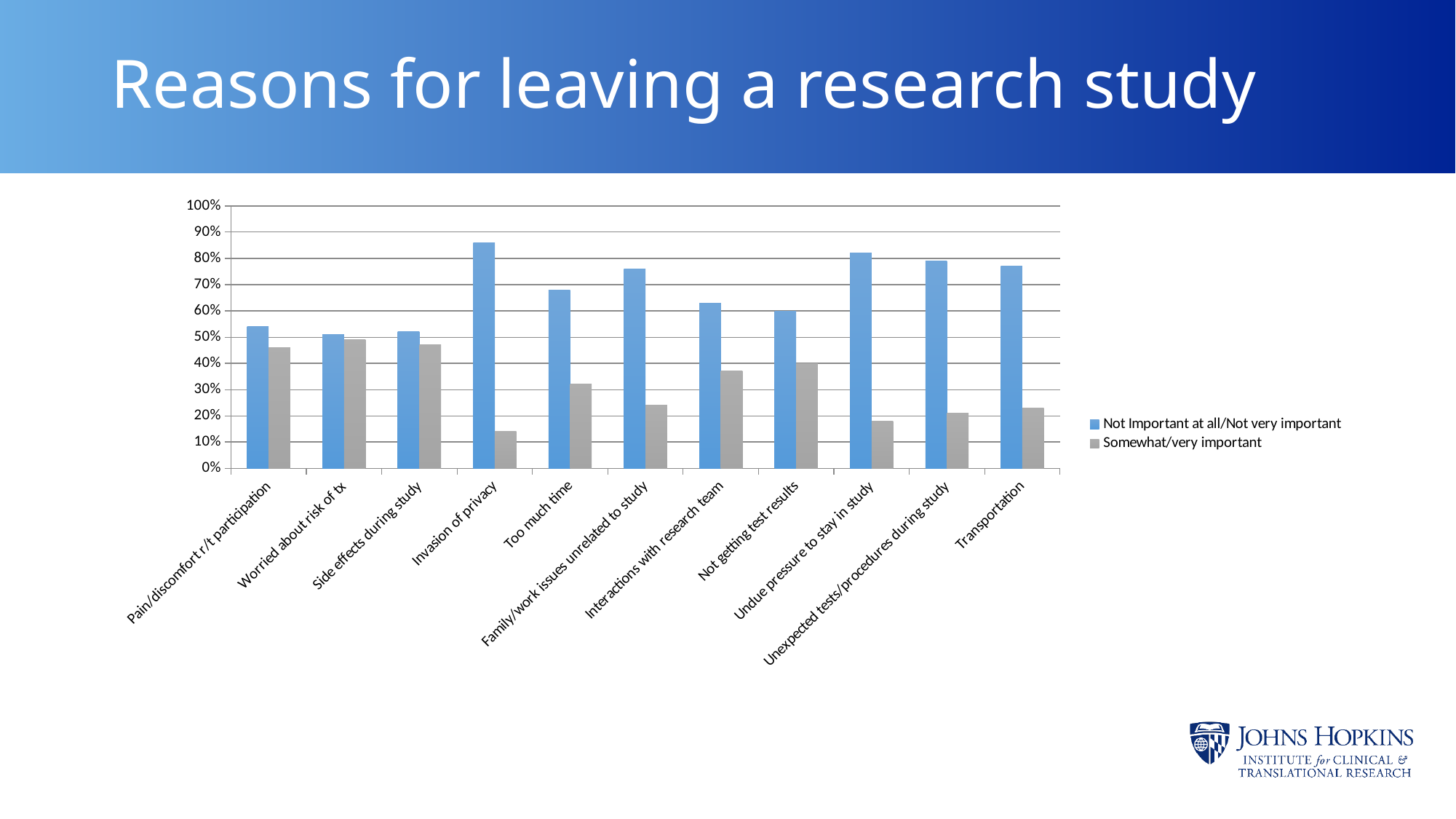
For Family/work issues unrelated to study, which series has the larger value: 'Not Important at all/Not very important' or 'Somewhat/very important'? Not Important at all/Not very important Which reason has the highest value for 'Not Important at all/Not very important'? Invasion of privacy Is the 'Not Important at all/Not very important' value for Undue pressure to stay in study greater or less than 70%? greater Is the 'Somewhat/very important' value for Transportation greater or less than 30%? less What is the title of the slide containing the chart? Reasons for leaving a research study Is the 'Not Important at all/Not very important' value for Invasion of privacy greater or less than 80%? greater How many series does the legend list? 2 Which is larger: the 'Not Important at all/Not very important' value for Invasion of privacy or for Too much time? Invasion of privacy What kind of chart is shown on the slide? bar chart How many reasons (categories) are shown on the x axis? 11 Which reason has the lowest value for 'Somewhat/very important'? Invasion of privacy